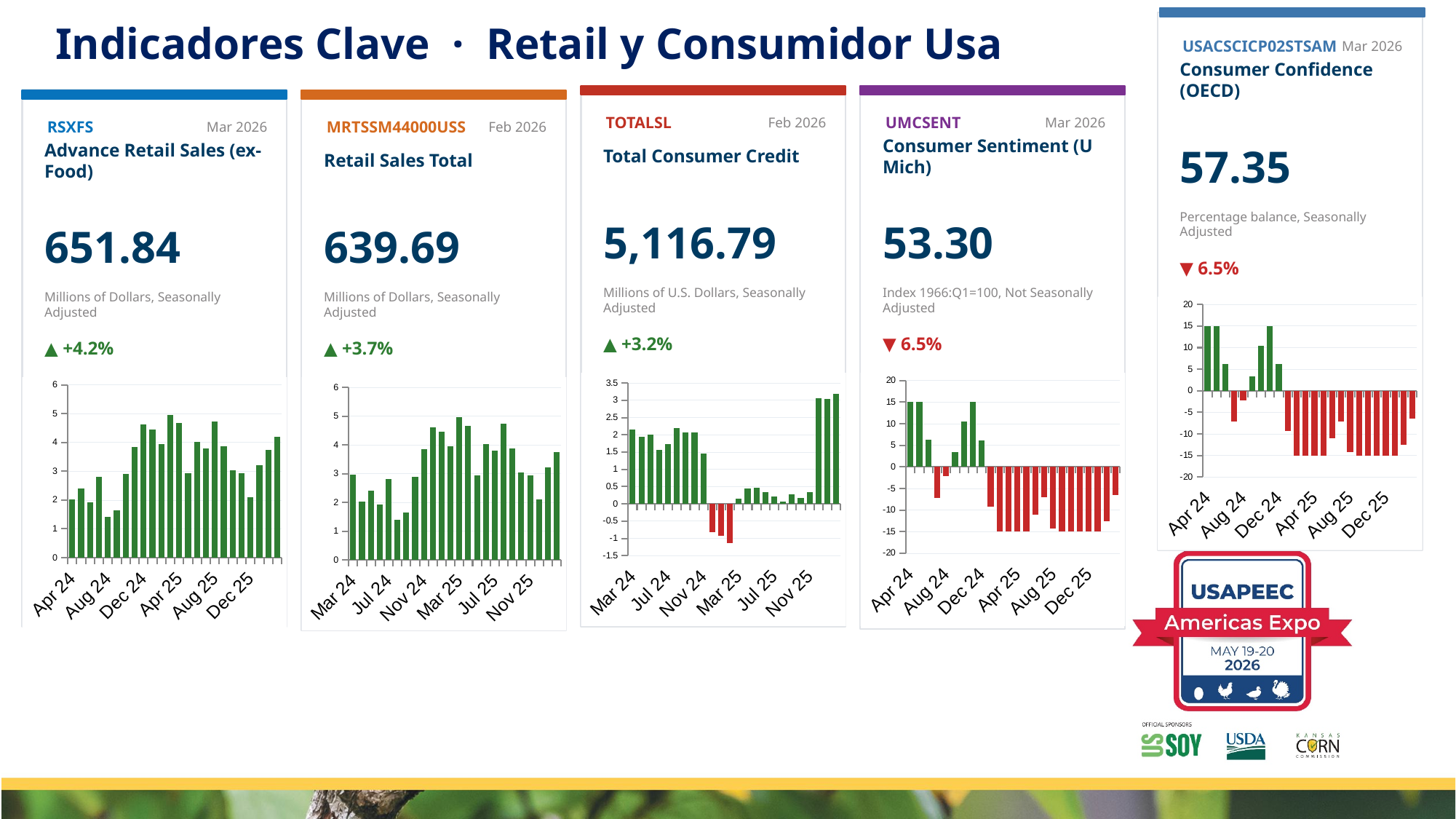
On the Consumer Confidence (OECD) card, what is the headline value shown? 57.35 Which headline value is larger: Advance Retail Sales (ex-Food) or Retail Sales Total? Advance Retail Sales (ex-Food) In the Total Consumer Credit chart, is the value of the last bar greater or less than 2.5? greater On the Total Consumer Credit card, what is the headline value shown? 5,116.79 What is the difference between the Advance Retail Sales (ex-Food) headline value (651.84) and the Retail Sales Total headline value (639.69)? 12.15 In the Consumer Sentiment (U Mich) chart, are the bars from Apr 25 onward above or below zero? below What kind of chart is used on each of the indicator cards? Bar chart How many indicator charts are shown on the slide? 5 On the Retail Sales Total card, what is the headline value shown? 639.69 On the Advance Retail Sales (ex-Food) card, what percentage change is shown? +4.2% On the Advance Retail Sales (ex-Food) card, what is the headline value shown? 651.84 On the Consumer Sentiment (U Mich) card, what is the headline value shown? 53.30